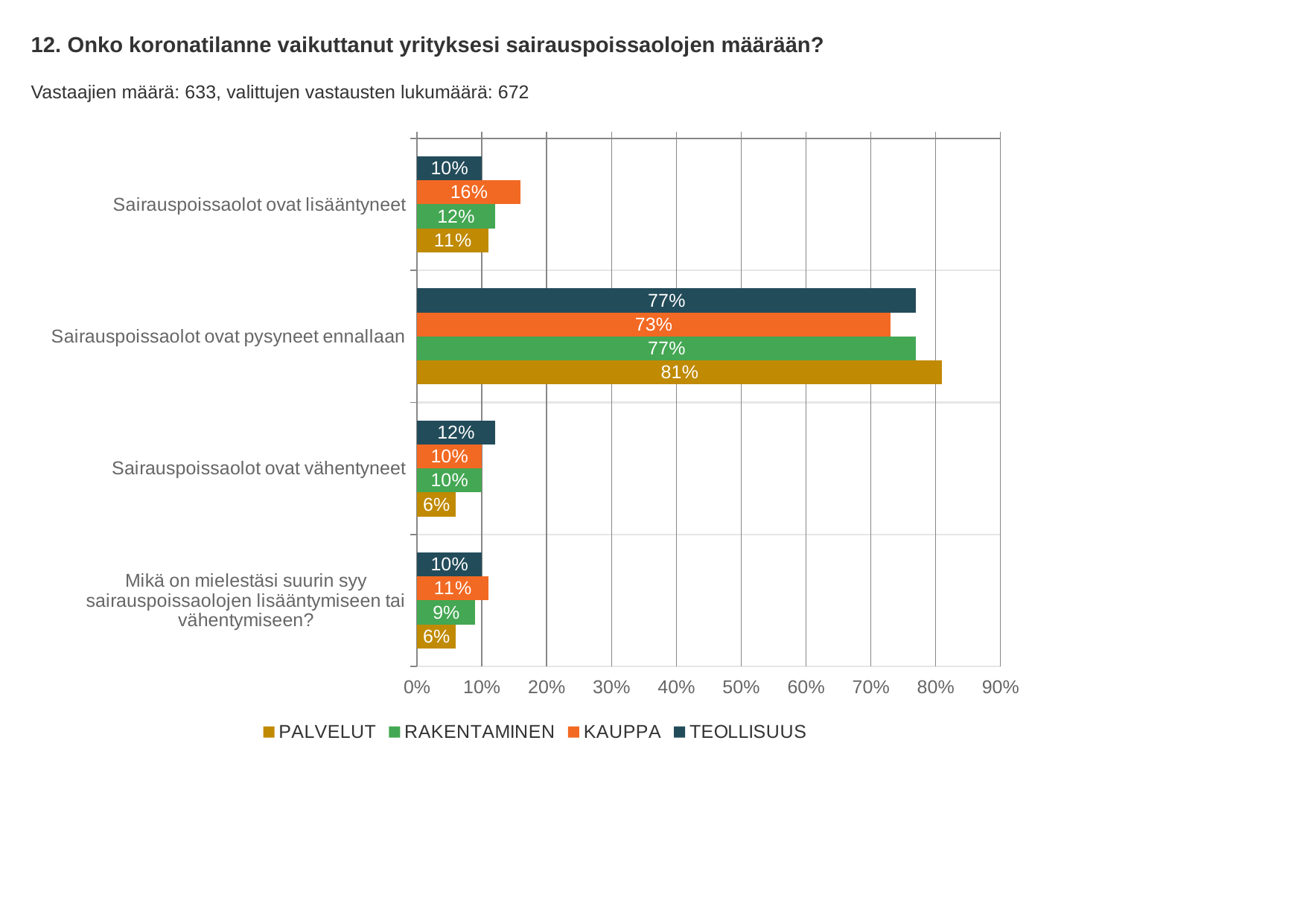
Which series has the highest value in the category "Sairauspoissaolot ovat pysyneet ennallaan"? PALVELUT How many series does the legend list? 4 What is the value for KAUPPA in the category "Sairauspoissaolot ovat lisääntyneet"? 16% Which legend entry is shown in orange? KAUPPA What is the value for RAKENTAMINEN in the category "Mikä on mielestäsi suurin syy sairauspoissaolojen lisääntymiseen tai vähentymiseen?"? 9% Which series has the lowest value in the category "Sairauspoissaolot ovat vähentyneet"? PALVELUT In the category "Sairauspoissaolot ovat lisääntyneet", which is larger: the value for KAUPPA or the value for TEOLLISUUS? KAUPPA What is the value for TEOLLISUUS in the category "Sairauspoissaolot ovat vähentyneet"? 12% What is the difference between the PALVELUT and KAUPPA values in the category "Sairauspoissaolot ovat pysyneet ennallaan"? 8% What is the value for PALVELUT in the category "Sairauspoissaolot ovat pysyneet ennallaan"? 81% How many categories are shown on the chart? 4 What kind of chart is shown on the slide? bar chart